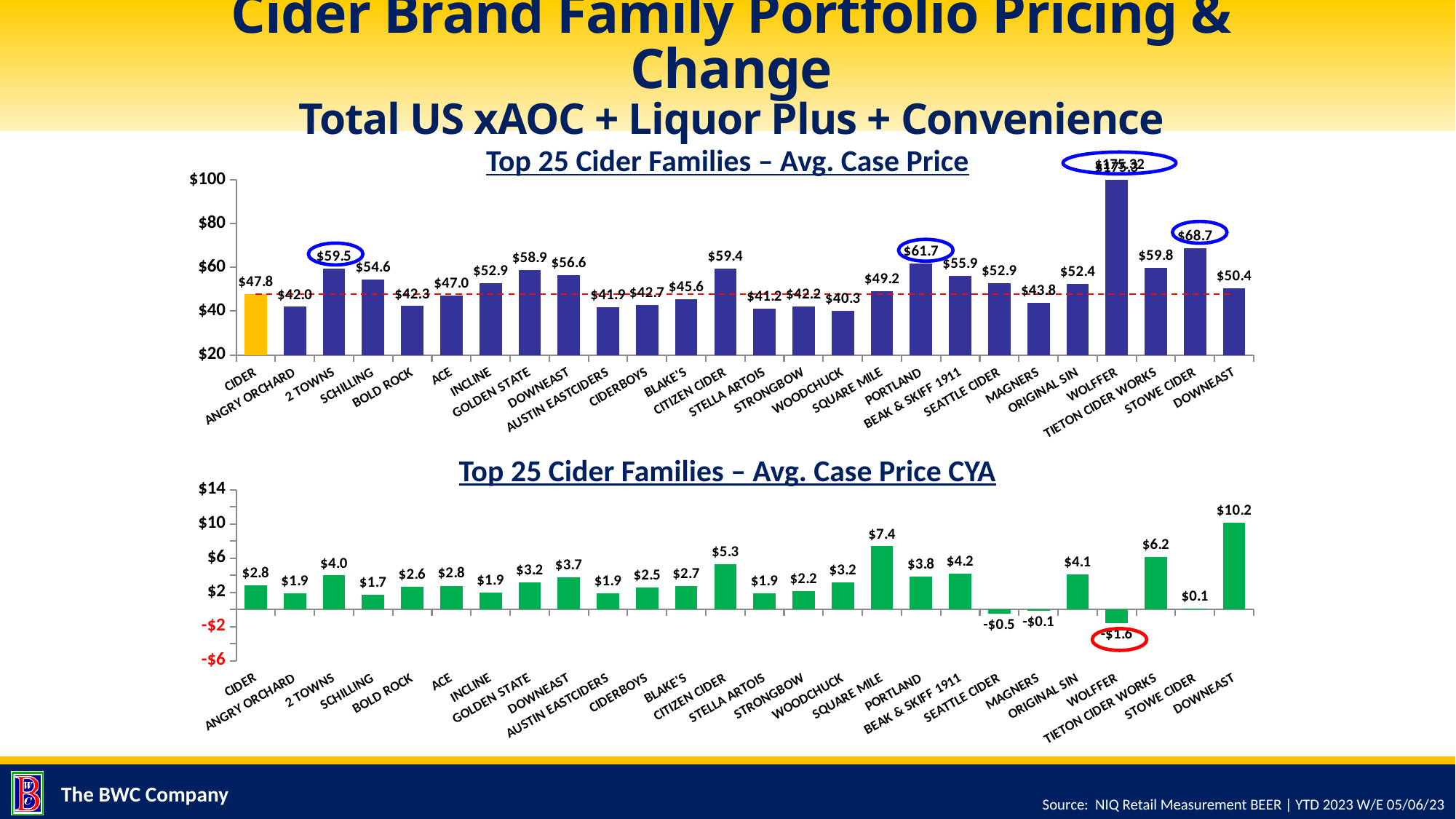
In the Top 25 Cider Families – Avg. Case Price chart, which family has the highest average case price? WOLFFER In the Top 25 Cider Families – Avg. Case Price chart, what is the average case price for PORTLAND? $61.7 In the Top 25 Cider Families – Avg. Case Price CYA chart, how many families show a negative value? 3 In the Top 25 Cider Families – Avg. Case Price CYA chart, what is the value for SQUARE MILE? $7.4 In the Top 25 Cider Families – Avg. Case Price chart, how much higher is the average case price of 2 TOWNS than SCHILLING? $4.9 In the Top 25 Cider Families – Avg. Case Price CYA chart, what is the value for WOLFFER? -$1.6 In the Top 25 Cider Families – Avg. Case Price chart, what is the average case price for STOWE CIDER? $68.7 In the Top 25 Cider Families – Avg. Case Price CYA chart, which family has the largest change? DOWNEAST In the Top 25 Cider Families – Avg. Case Price chart, which has the higher average case price, CITIZEN CIDER or GOLDEN STATE? CITIZEN CIDER What type of chart is the Top 25 Cider Families – Avg. Case Price chart? Bar chart In the Top 25 Cider Families – Avg. Case Price CYA chart, which family has the lowest value? WOLFFER In the Top 25 Cider Families – Avg. Case Price chart, which family has the lowest average case price? WOODCHUCK